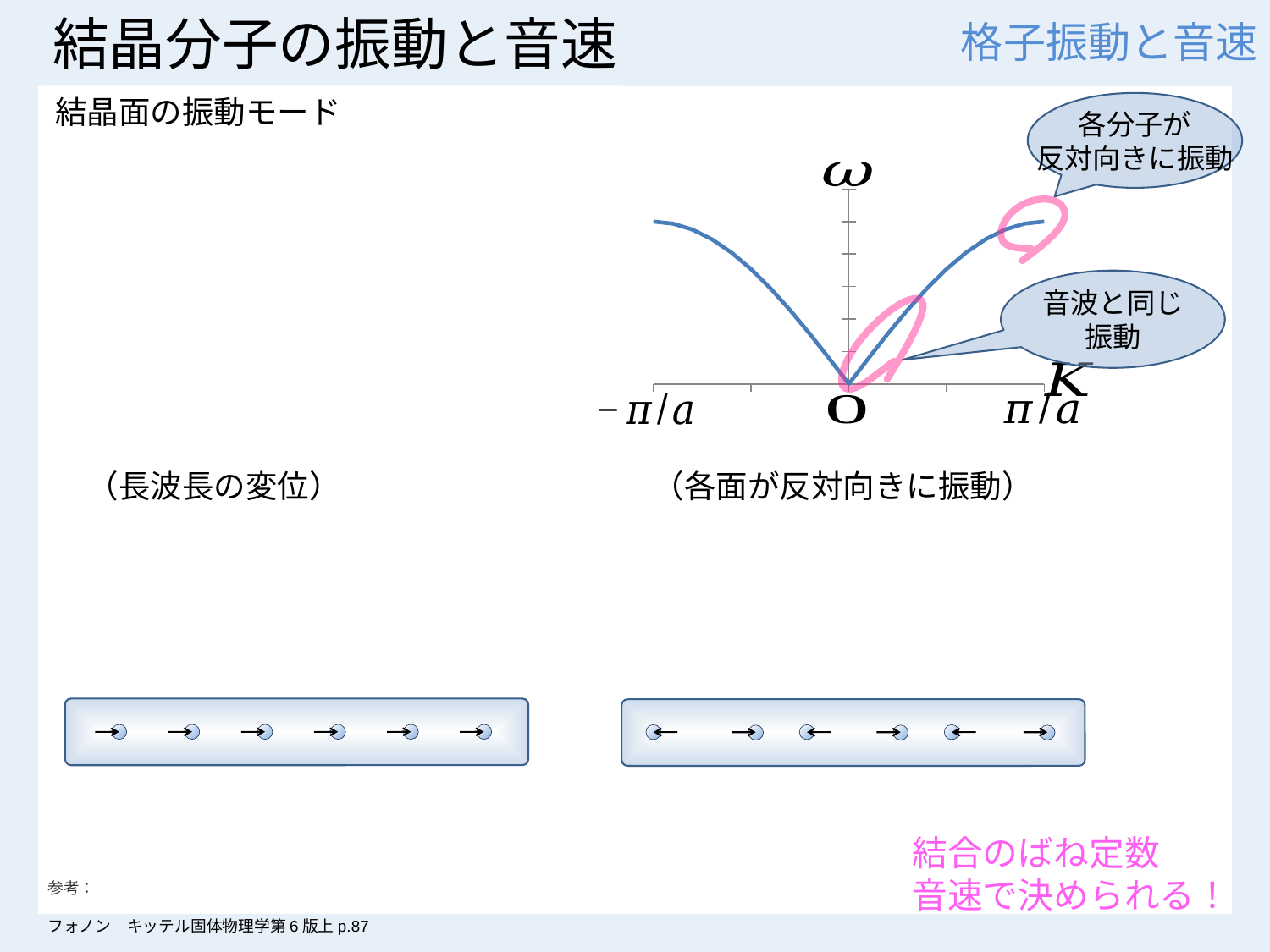
Moving along the horizontal axis from O to π/a, does ω rise or fall? rise Moving along the horizontal axis from -π/a to O, does ω rise or fall? fall How many curves are plotted on the chart? 1 What kind of chart is the ω versus K plot on the slide? line chart What is the label on the horizontal axis of the chart? K Which has the larger value of ω on the curve: K = O or K = π/a? π/a What is the label on the vertical axis of the chart? ω At which point on the horizontal axis does the curve reach its lowest value of ω? O